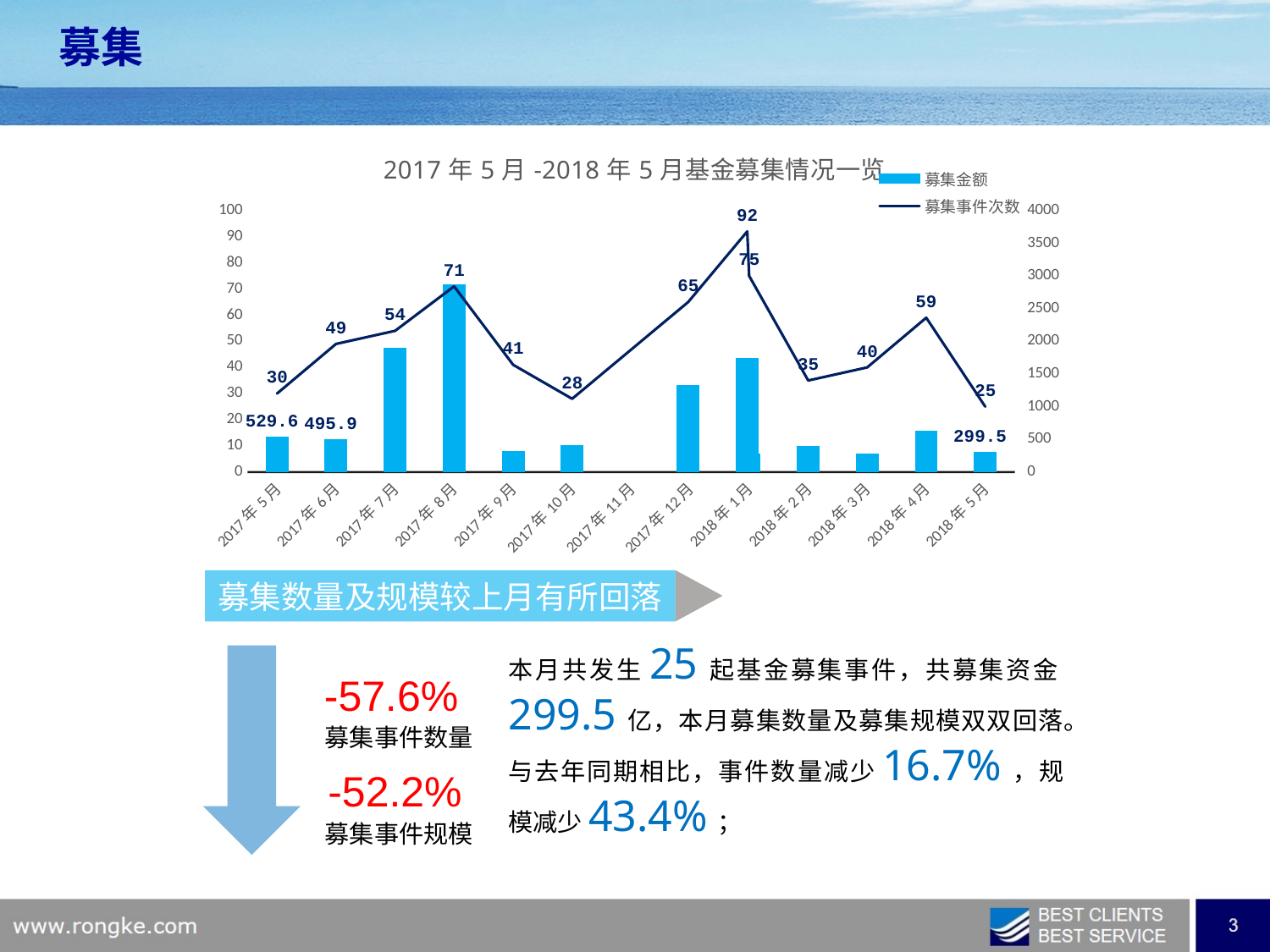
What is the 募集事件次数 value for 2017年8月? 71 What is the 募集事件次数 value for 2018年5月? 25 What is the title of the chart? 2017年5月-2018年5月基金募集情况一览 Which has a larger 募集金额, 2017年5月 or 2018年5月? 2017年5月 What is the difference between the 募集金额 for 2017年5月 and 2017年6月? 33.7 Does the 募集事件次数 line rise or fall from 2018年4月 to 2018年5月? fall Is the 募集金额 bar for 2017年8月 greater or less than 2500 on the right axis? greater What is the 募集金额 value for 2017年5月? 529.6 What is the difference in 募集事件次数 between 2018年4月 and 2018年5月? 34 How many series does the chart legend list? 2 What kind of chart is shown on the slide? Combination bar and line chart How many months (categories) are shown on the x axis? 13